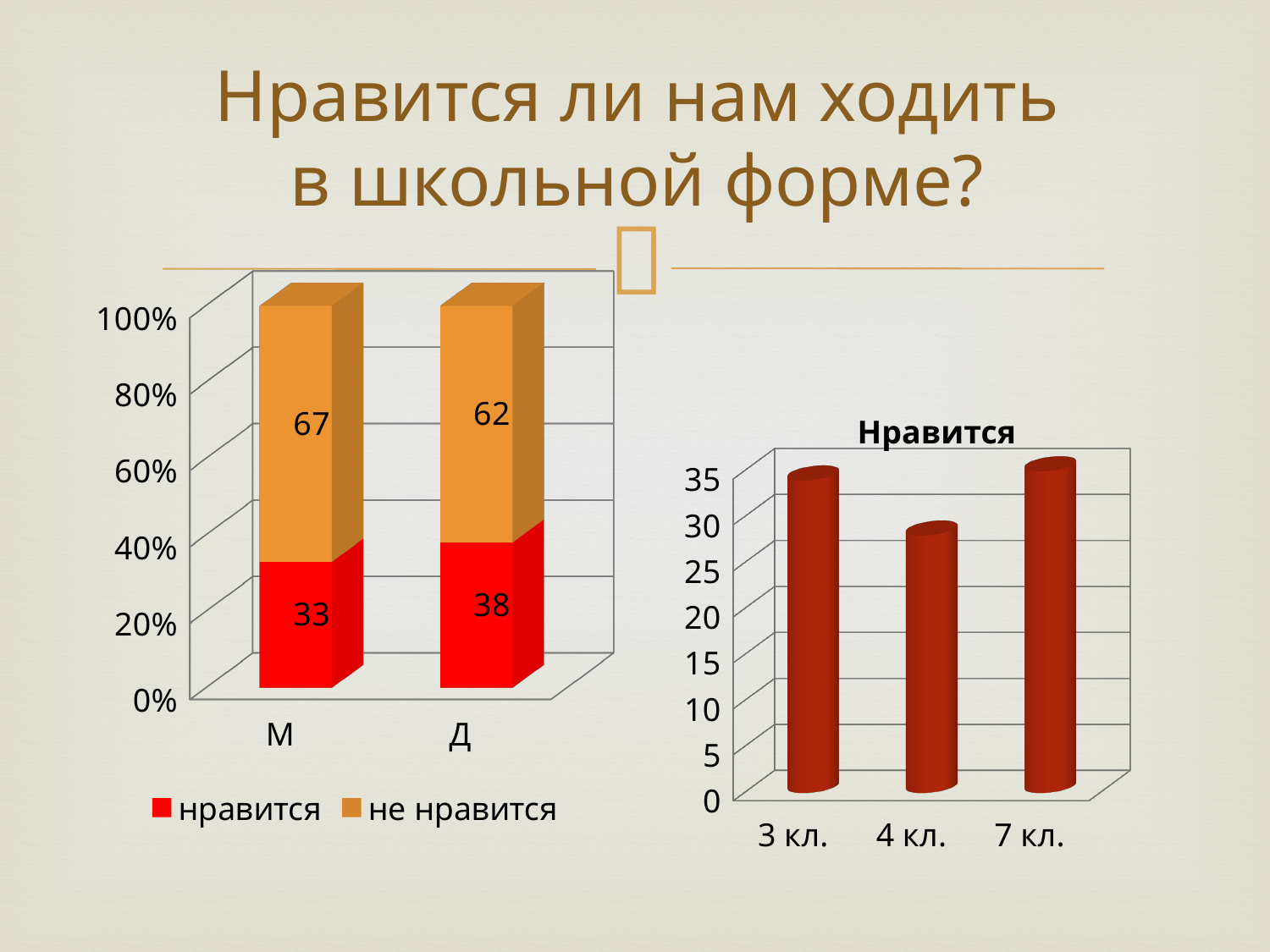
In the left stacked bar chart, what is the total of the two segments for М? 100 In the left stacked bar chart, which category has the larger 'нравится' value, М or Д? Д In the left stacked bar chart, what is the value of 'нравится' for М? 33 In the chart titled 'Нравится', is the value for 4 кл. greater or less than 30? less In the left stacked bar chart, which colour represents 'не нравится'? Orange In the left stacked bar chart, what is the difference between the 'не нравится' values for М and Д? 5 In the chart titled 'Нравится', which category has the lowest value? 4 кл. How many series does the legend of the left stacked bar chart list? 2 In the left stacked bar chart, what is the value of 'не нравится' for Д? 62 What is the title of the chart on the right? Нравится In the left stacked bar chart, what is the value of 'не нравится' for М? 67 In the chart titled 'Нравится', how many categories are shown on the x axis? 3